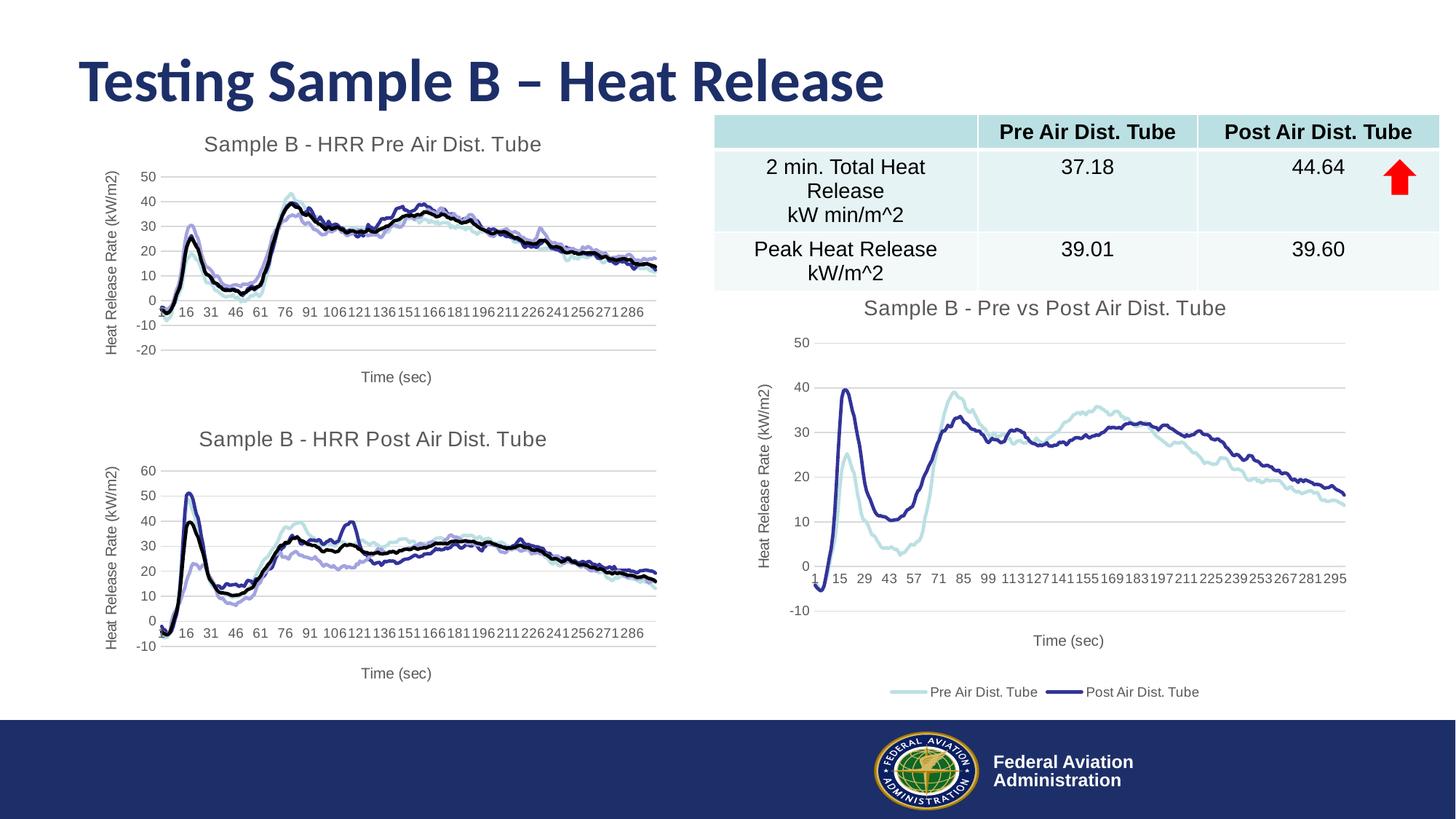
What is the y-axis label of the 'Sample B - HRR Pre Air Dist. Tube' chart? Heat Release Rate (kW/m2) In the 'Sample B - Pre vs Post Air Dist. Tube' chart, which series is higher at the first peak around 15 sec? Post Air Dist. Tube In the 'Sample B - Pre vs Post Air Dist. Tube' chart, is the Pre Air Dist. Tube value at 295 sec greater or less than 20? less How many charts are shown on the slide? 3 In the 'Sample B - HRR Pre Air Dist. Tube' chart, is the peak of the black line greater or less than 30? greater How many series does the legend of the 'Sample B - Pre vs Post Air Dist. Tube' chart list? 2 In the 'Sample B - Pre vs Post Air Dist. Tube' chart, which series is higher at around 85 sec? Pre Air Dist. Tube In the 'Sample B - Pre vs Post Air Dist. Tube' chart, is the highest value of the Post Air Dist. Tube line greater or less than 30? greater What kind of chart is 'Sample B - Pre vs Post Air Dist. Tube'? line chart What are the two legend entries in the 'Sample B - Pre vs Post Air Dist. Tube' chart? Pre Air Dist. Tube and Post Air Dist. Tube In the 'Sample B - Pre vs Post Air Dist. Tube' chart, do the values rise or fall between about 200 sec and 295 sec? fall